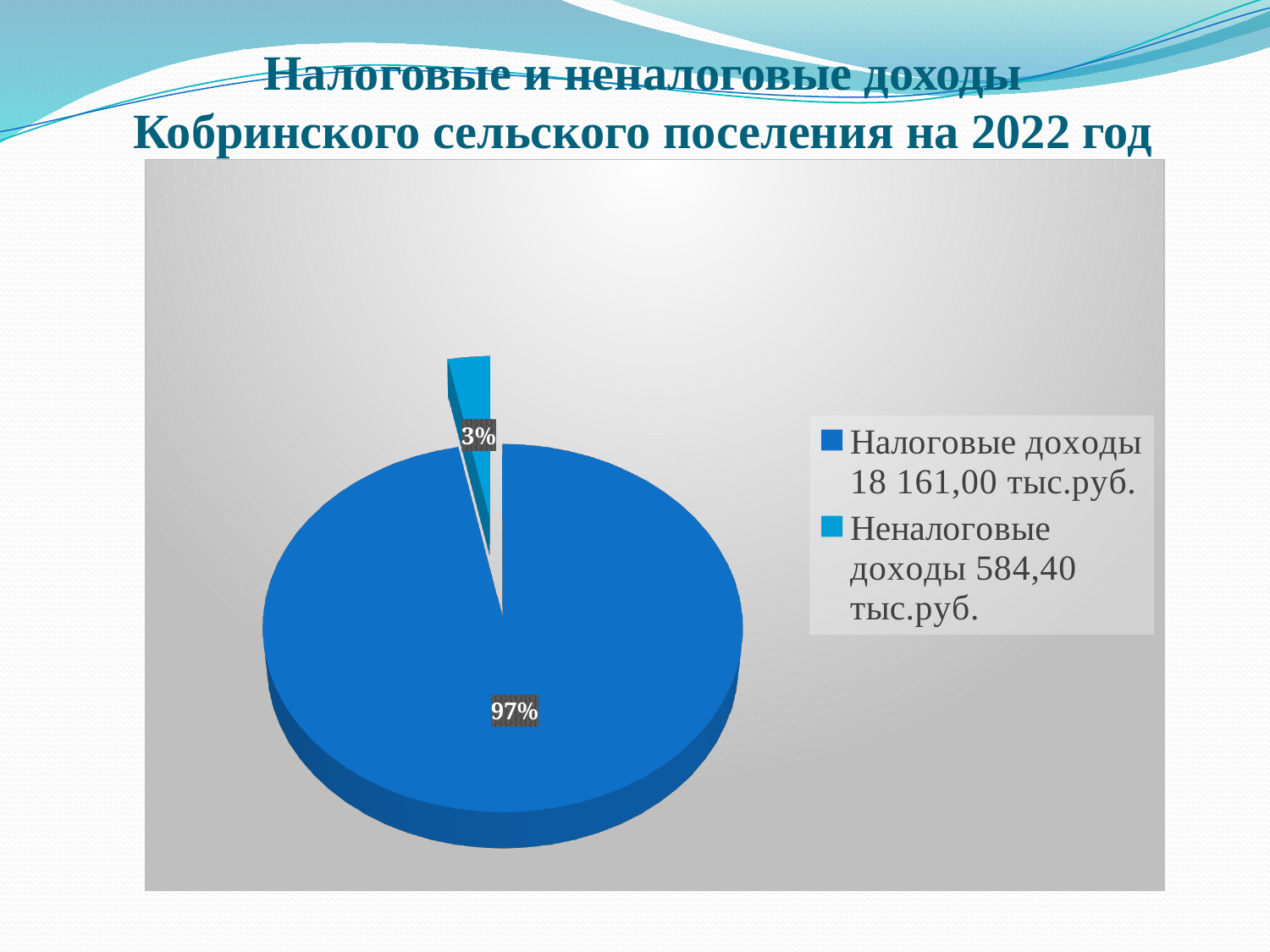
How many entries does the legend list? 2 What amount in тыс.руб. does the legend give for Неналоговые доходы? 584,40 тыс.руб. What is the difference in percentage points between the Налоговые доходы and Неналоговые доходы slices? 94 Which slice is the largest? Налоговые доходы Which slice is the smallest? Неналоговые доходы What kind of chart is shown on the slide? pie chart What share of the pie does Неналоговые доходы take? 3% What amount in тыс.руб. does the legend give for Налоговые доходы? 18 161,00 тыс.руб. What year does the slide title say the data is for? 2022 Which is larger, the Налоговые доходы slice or the Неналоговые доходы slice? Налоговые доходы What share of the pie does Налоговые доходы take? 97% How many slices does the pie chart have? 2